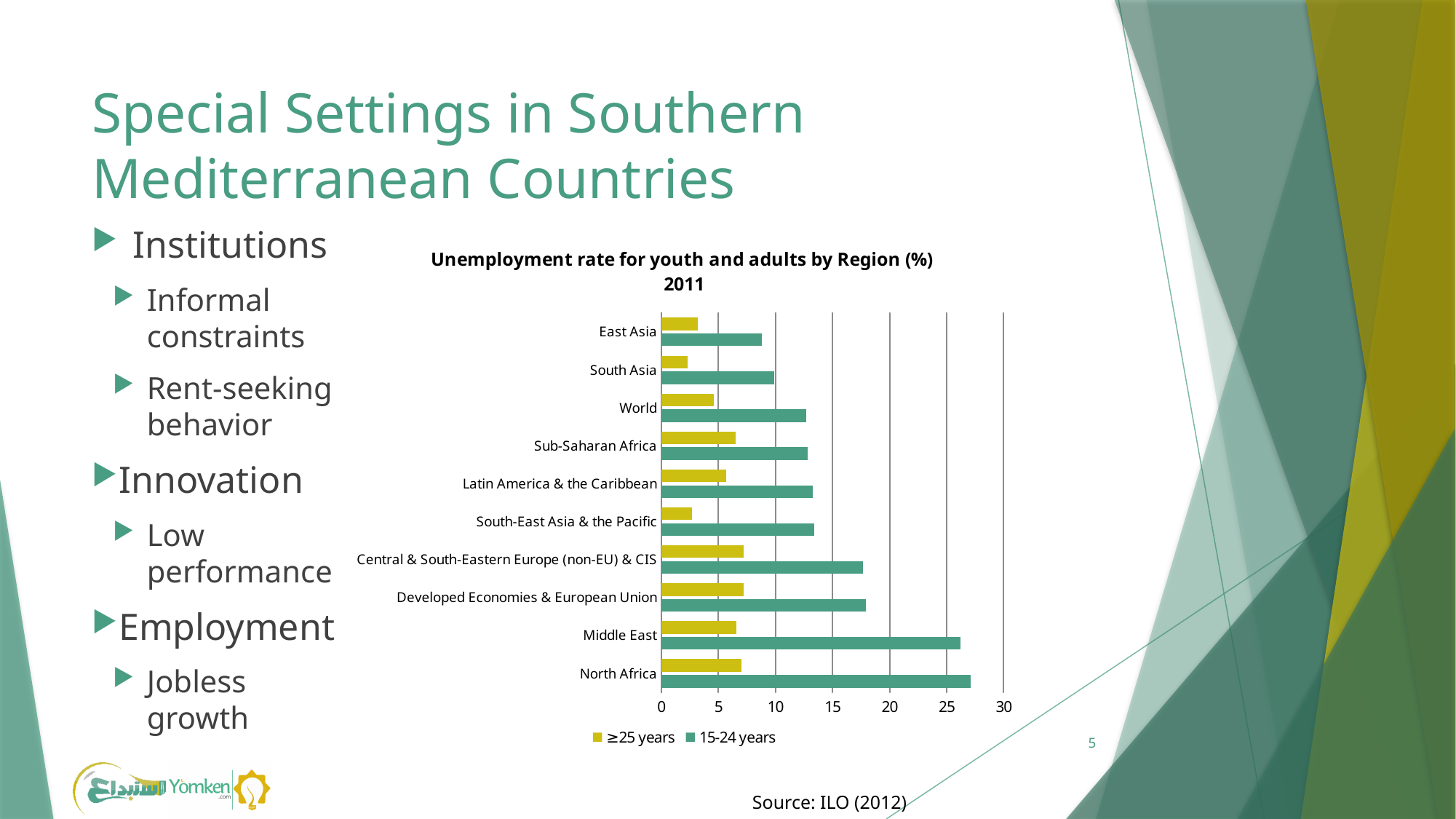
How many regions are plotted on the chart? 10 Is the 15-24 years value for Sub-Saharan Africa greater or less than 10? greater What kind of chart is shown on the slide? bar chart Which is larger, the 15-24 years value for the Middle East or the 15-24 years value for World? Middle East What is the title of the chart? Unemployment rate for youth and adults by Region (%) 2011 Is the 15-24 years value for North Africa greater or less than 25? greater Is the 15-24 years value for Developed Economies & European Union greater or less than 15? greater For North Africa, which series has the larger value, 15-24 years or ≥25 years? 15-24 years How many series does the legend list? 2 Which series is shown in yellow in the legend? ≥25 years